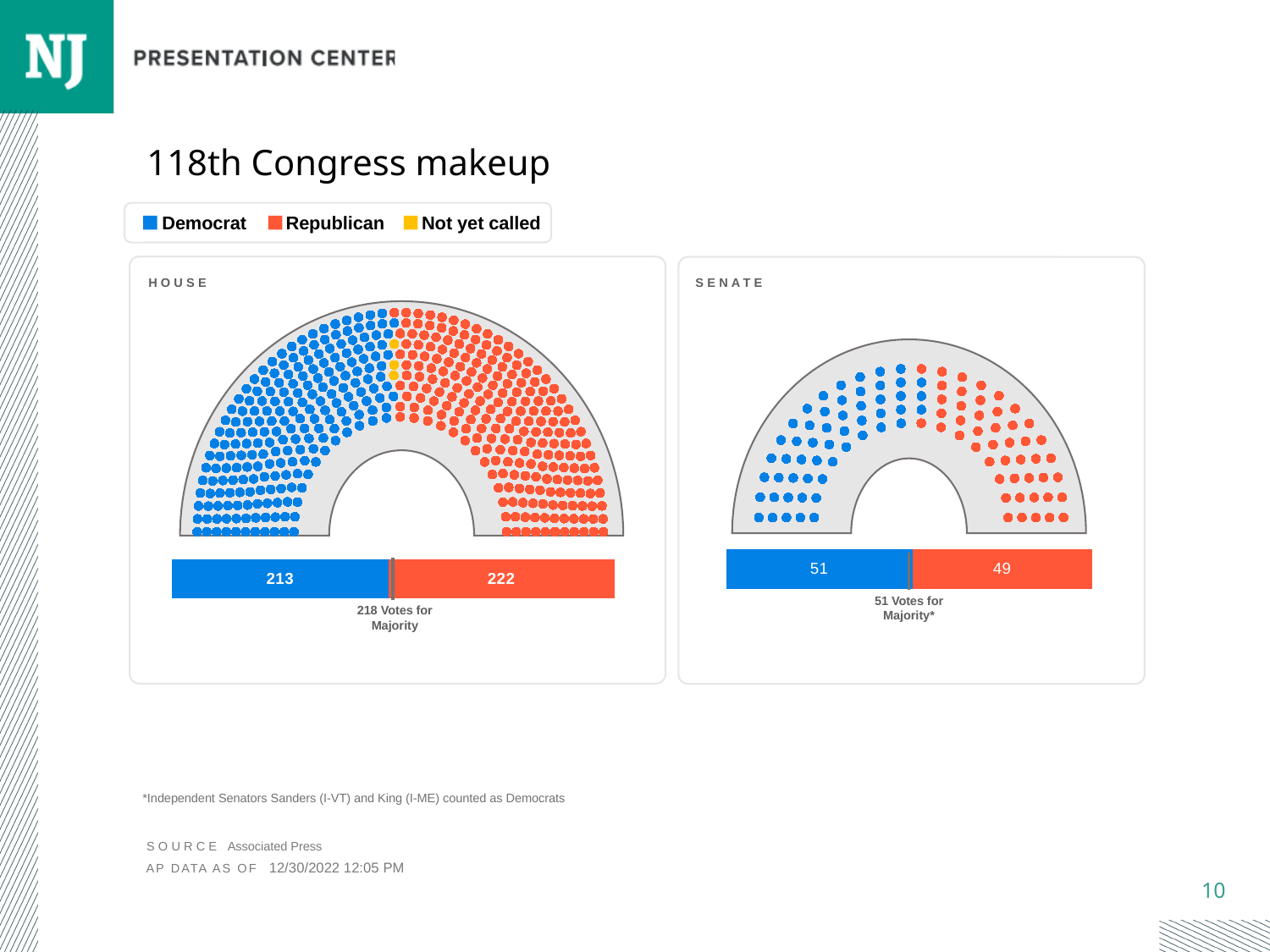
In the Senate chart, how many seats are shown for Republicans? 49 In the House chart, how many seats are shown for Republicans? 222 In the Senate chart, what is the difference between the Democrat and Republican seat counts? 2 In the House chart, what is the total of the Democrat and Republican seats in the bar? 435 How many entries does the legend at the top of the slide list? 3 In the Senate chart, which party has more seats, Democrats or Republicans? Democrats In the Senate chart, what is the total of the Democrat and Republican seats in the bar? 100 In the Senate chart, how many seats are shown for Democrats? 51 In the House chart, which party has more seats, Democrats or Republicans? Republicans In the House chart, what is the difference between the Republican and Democrat seat counts? 9 In the House chart, how many seats are shown for Democrats? 213 In the House chart, how many votes are needed for a majority according to the label? 218